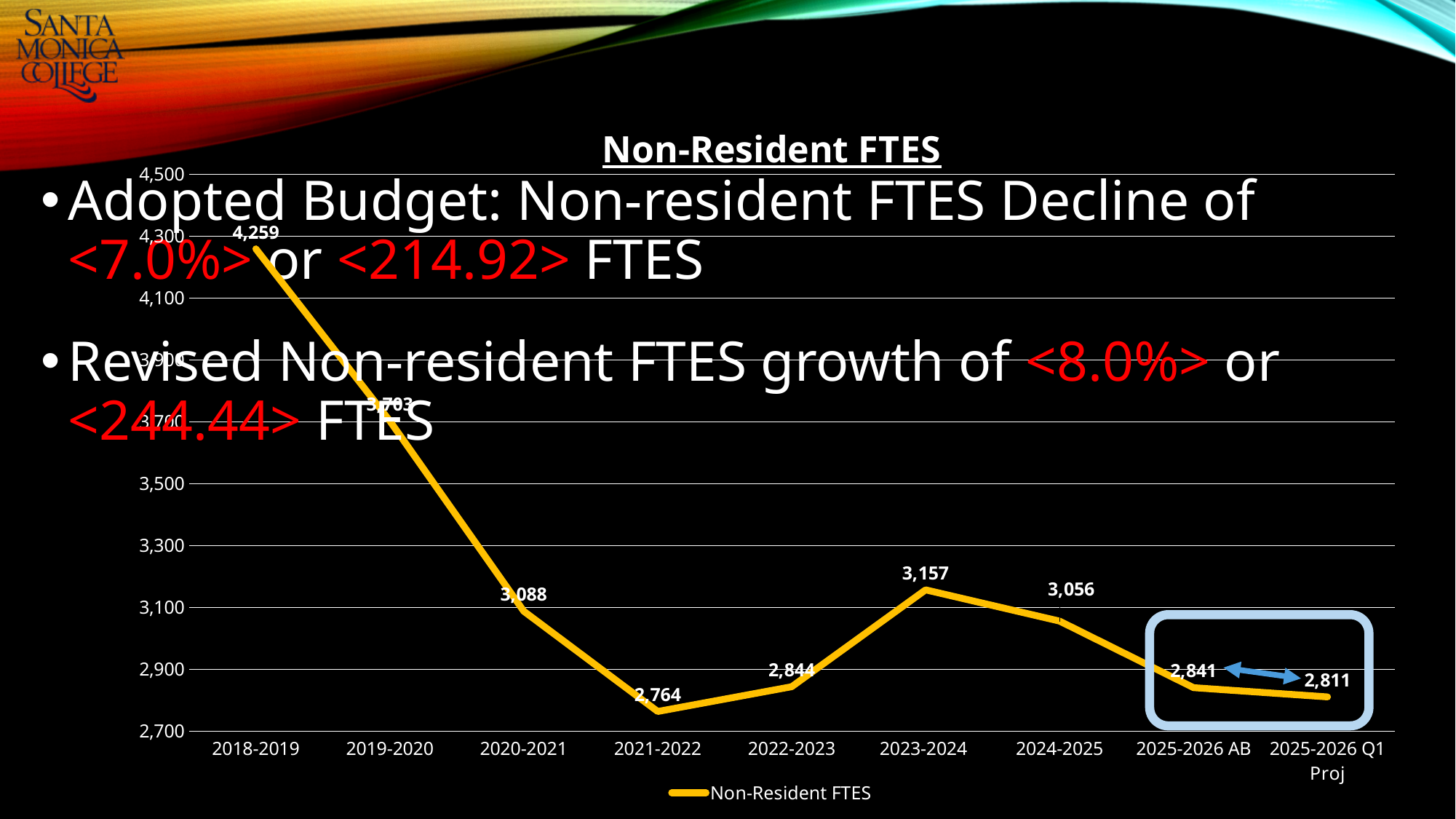
Is the Non-Resident FTES value for 2020-2021 greater or less than 2,900? greater Which year has the lowest Non-Resident FTES? 2021-2022 What is the Non-Resident FTES value for 2025-2026 Q1 Proj? 2,811 What kind of chart is shown on the slide? line chart How many series does the chart legend list? 1 What is the Non-Resident FTES value for 2021-2022? 2,764 What is the difference between the Non-Resident FTES for 2025-2026 AB and 2025-2026 Q1 Proj? 30 How many years are shown on the x axis of the chart? 9 What is the Non-Resident FTES value for 2018-2019? 4,259 What is the Non-Resident FTES value for 2023-2024? 3,157 Which is larger, the Non-Resident FTES for 2023-2024 or for 2024-2025? 2023-2024 Which year has the highest Non-Resident FTES? 2018-2019